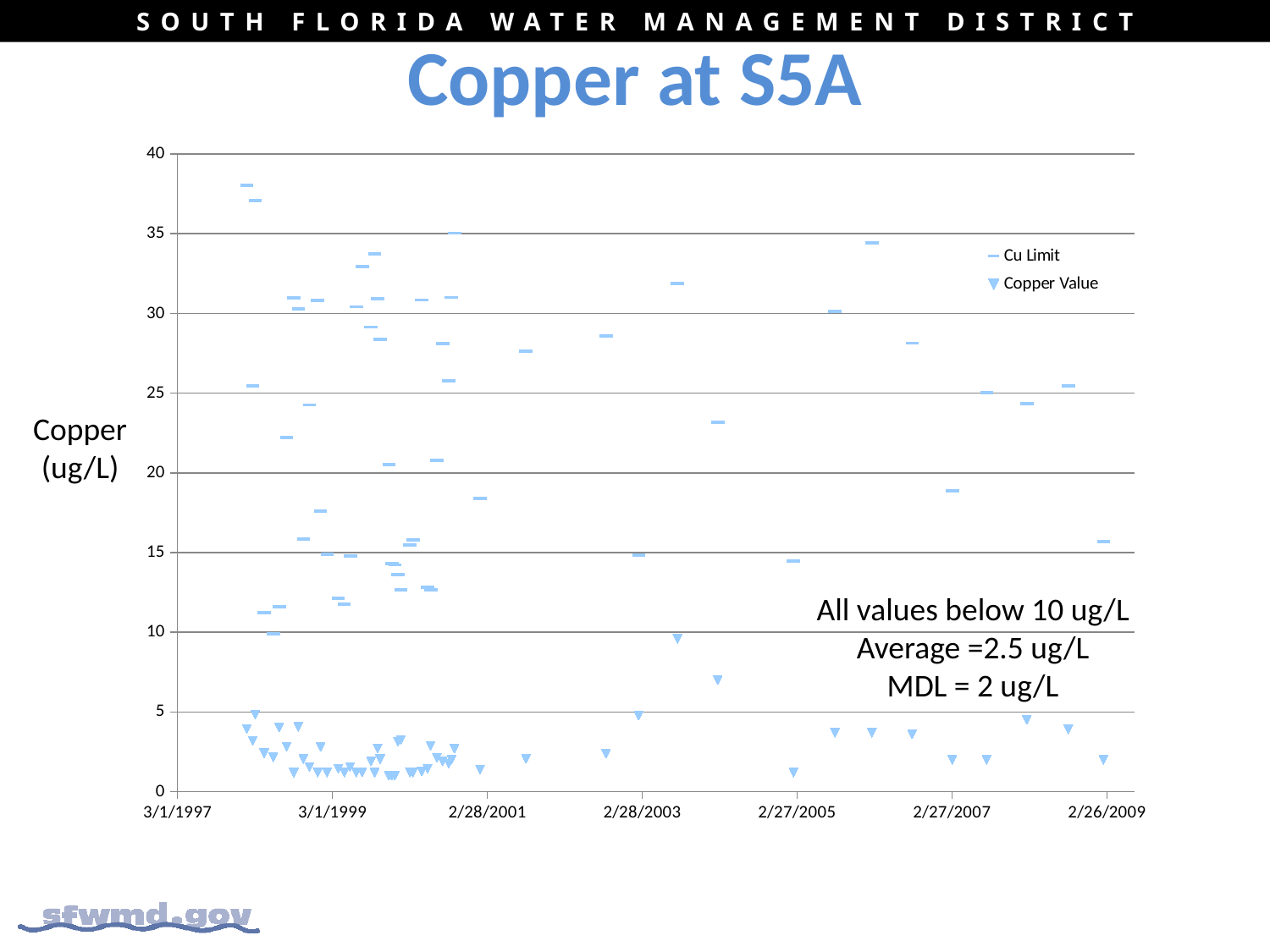
What are the two series named in the chart legend? Cu Limit and Copper Value According to the text on the chart, what is the average copper value? 2.5 ug/L Which series has the higher plotted values overall, Cu Limit or Copper Value? Cu Limit Is the highest Cu Limit point on the chart greater or less than 35? greater Is the Cu Limit point plotted near 2/26/2009 greater or less than 20? less According to the chart annotation, all Copper Values are below what level? 10 ug/L What is the maximum value shown on the vertical axis? 40 What is the title of the chart? Copper at S5A According to the text on the chart, what is the MDL? 2 ug/L What kind of chart is shown on the slide? scatter chart How many series does the chart legend list? 2